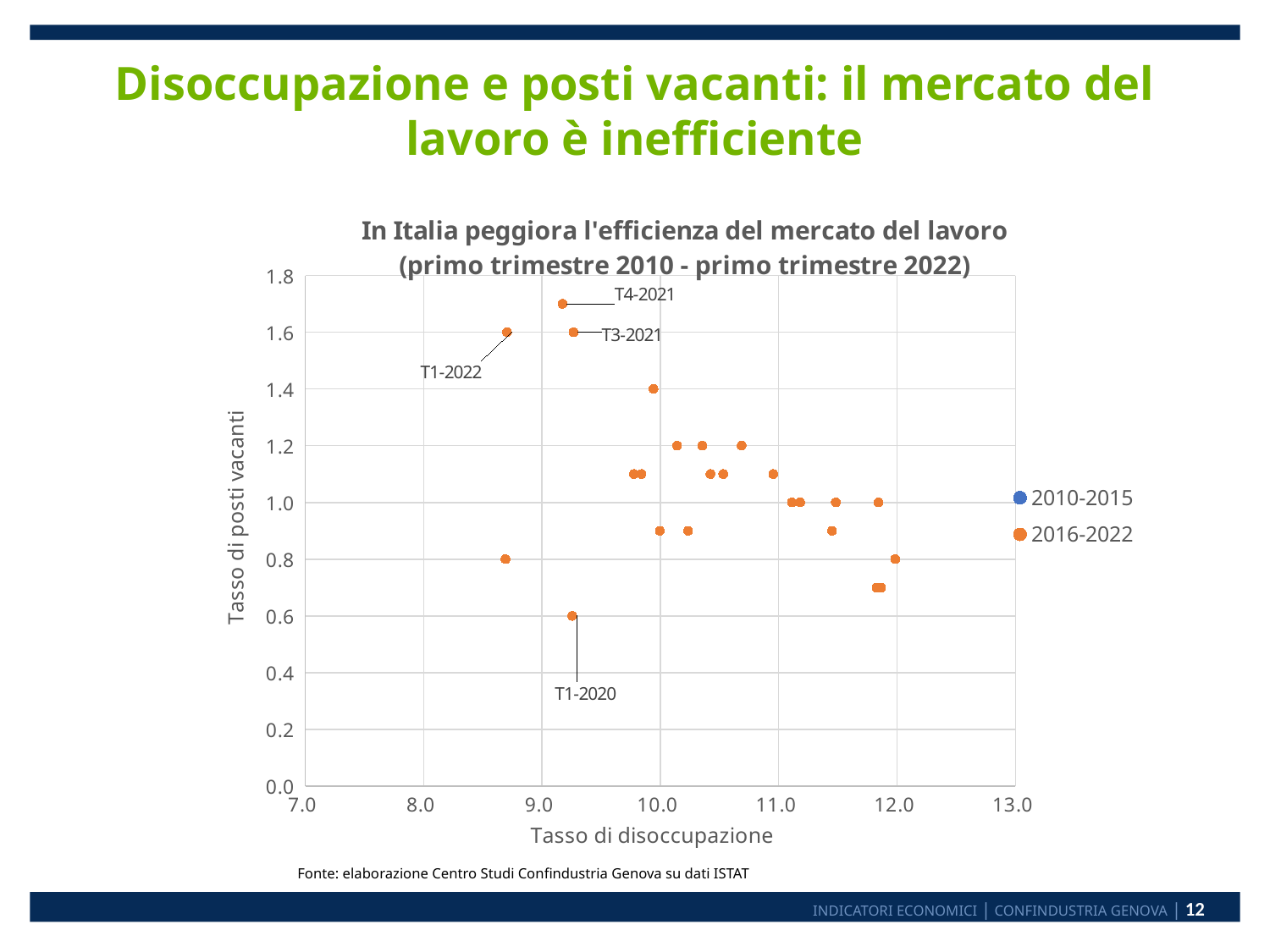
Which labelled point has the higher vacancy rate, T4-2021 or T3-2021? T4-2021 Is the vacancy rate for the point labelled T1-2020 greater or less than 0.8? less Which labelled point has the lowest vacancy rate? T1-2020 What kind of chart is shown on the slide? Scatter chart How many series does the legend list? 2 Which labelled point has the highest vacancy rate? T4-2021 Is the vacancy rate for the point labelled T4-2021 greater or less than 1.6? greater What is the vacancy rate (Tasso di posti vacanti) for the point labelled T3-2021? 1.6 What is the title of the x axis? Tasso di disoccupazione What is the vacancy rate (Tasso di posti vacanti) for the point labelled T1-2020? 0.6 What is the title of the y axis? Tasso di posti vacanti Is the unemployment rate (Tasso di disoccupazione) for the point labelled T1-2022 greater or less than 9.0? less